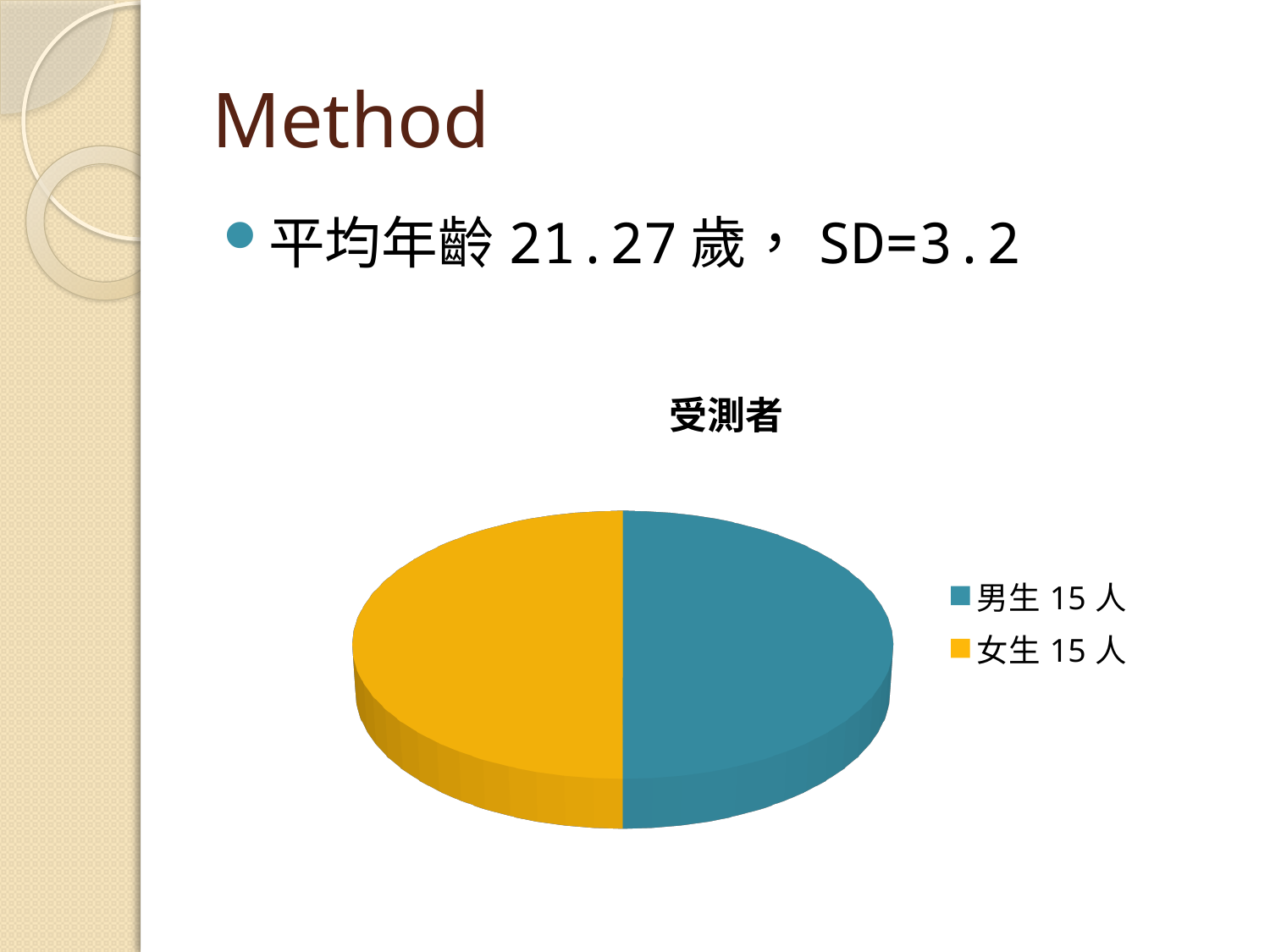
What kind of chart is shown on the slide? pie chart What is the total number of participants across both slices of the pie? 30 What share of the pie does the 男生 slice represent? 50% How many 男生 are shown in the chart legend? 15 人 What share of the pie does the 女生 slice represent? 50% How many slices does the pie chart have? 2 How many 女生 are shown in the chart legend? 15 人 Which colour represents 女生 in the pie chart? yellow How many entries does the legend list? 2 What is the title of the chart? 受測者 What is the difference between the number of 男生 and the number of 女生? 0